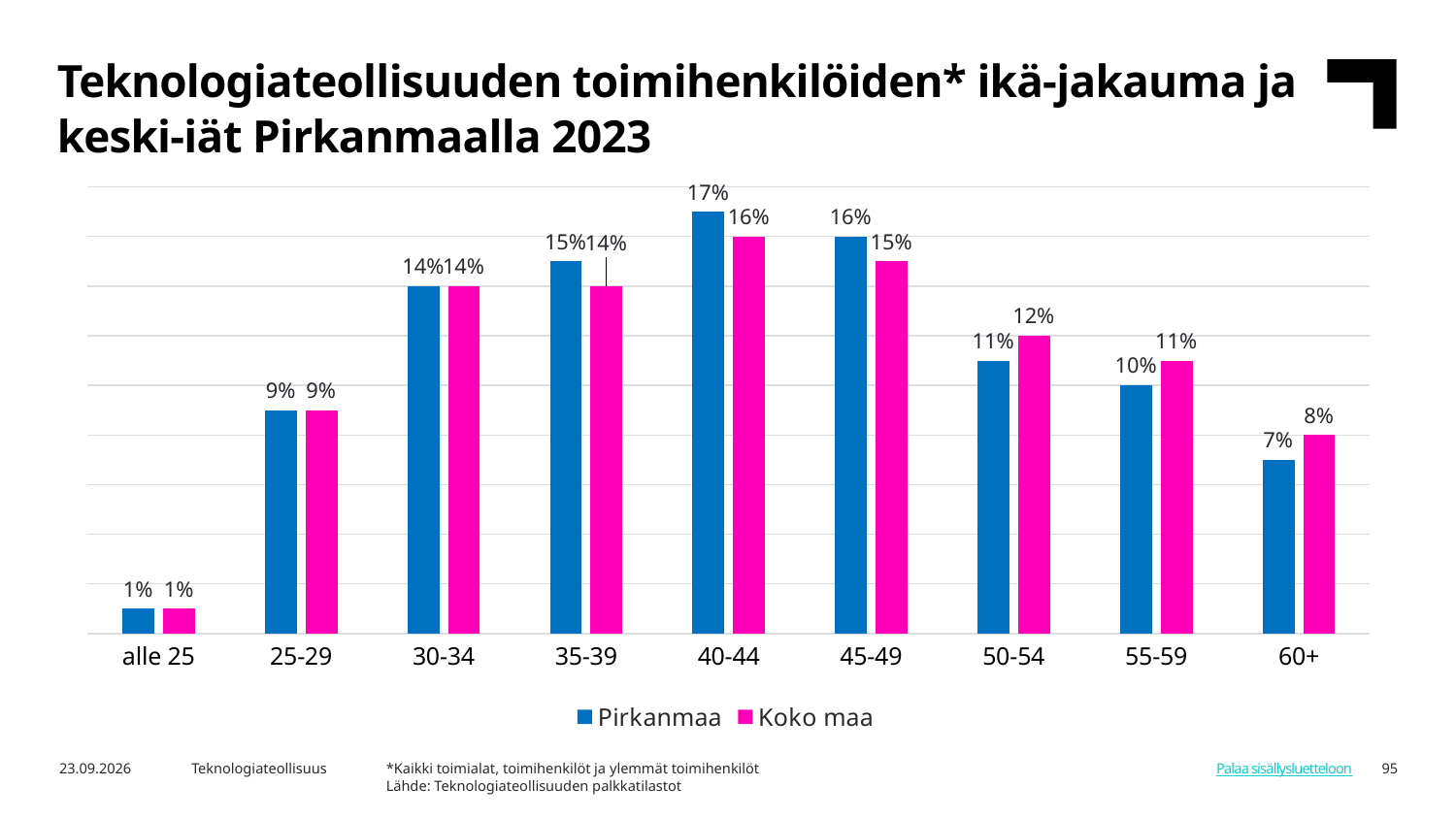
What is the value for Koko maa in the 50-54 age group? 12% How many age groups are shown on the x axis? 9 Which age group has the highest value for Pirkanmaa? 40-44 What is the difference between the Pirkanmaa and Koko maa values in the 45-49 age group? 1% How many series does the legend list? 2 What kind of chart is shown on the slide? Bar chart What is the value for Pirkanmaa in the 40-44 age group? 17% Which age group has the lowest value for Koko maa? alle 25 What is the value for Pirkanmaa in the 60+ age group? 7% Which series is shown in pink in the legend? Koko maa Do the Pirkanmaa values rise or fall from the 45-49 age group to the 60+ age group? Fall In the 55-59 age group, which series has the larger value, Pirkanmaa or Koko maa? Koko maa